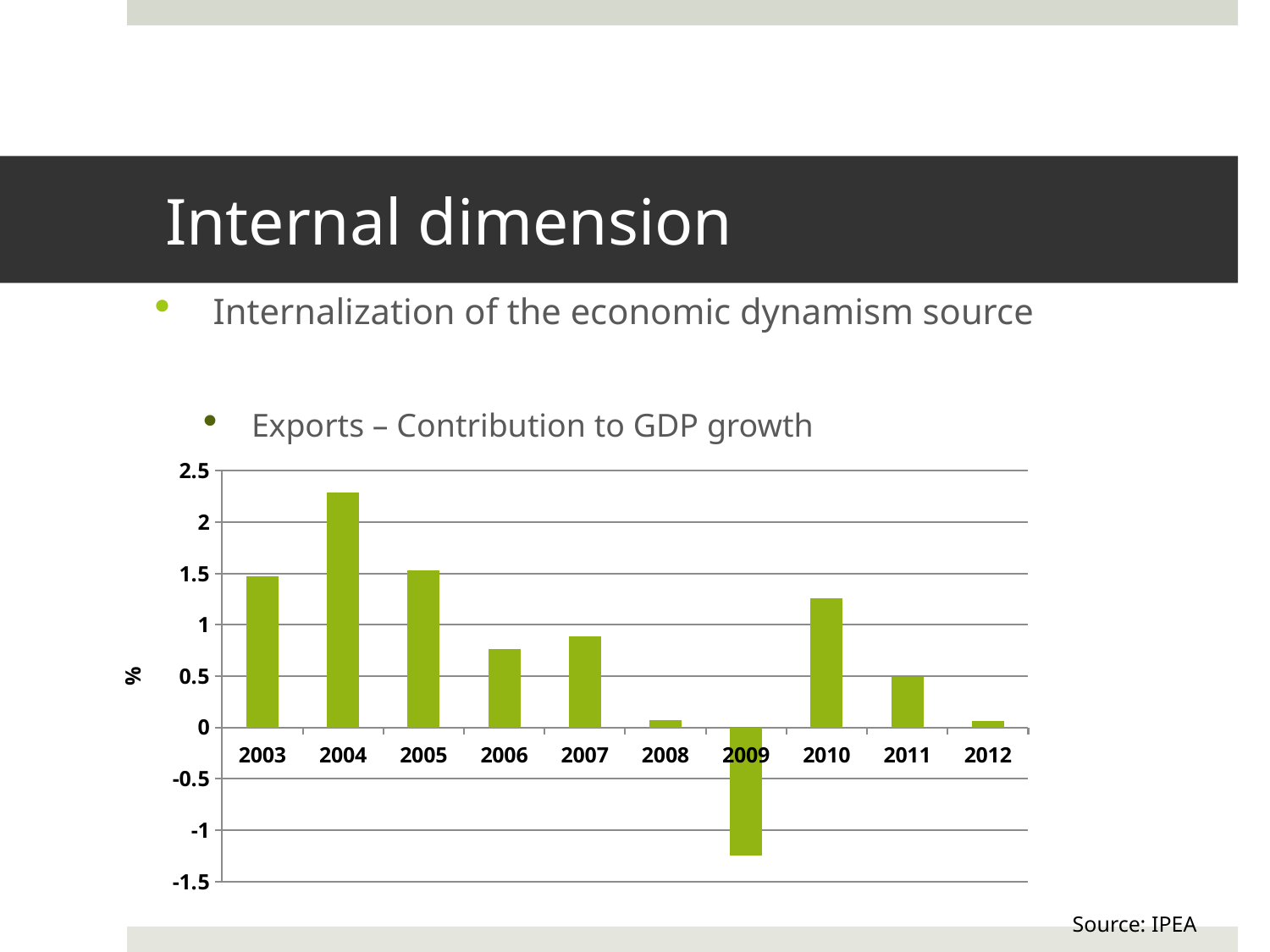
Do the values rise or fall from 2005 to 2009? fall Which year has the larger value, 2004 or 2005? 2004 What kind of chart is shown on the slide? bar chart How many years are shown on the x axis of the chart? 10 Is the value for 2010 greater or less than 1? greater Which year has the highest exports contribution to GDP growth? 2004 Is the value for 2004 greater or less than 2? greater Which year has the larger value, 2010 or 2011? 2010 Which year has the lowest exports contribution to GDP growth? 2009 What is the label on the vertical axis of the chart? % Is the value for 2006 greater or less than 0.5? greater